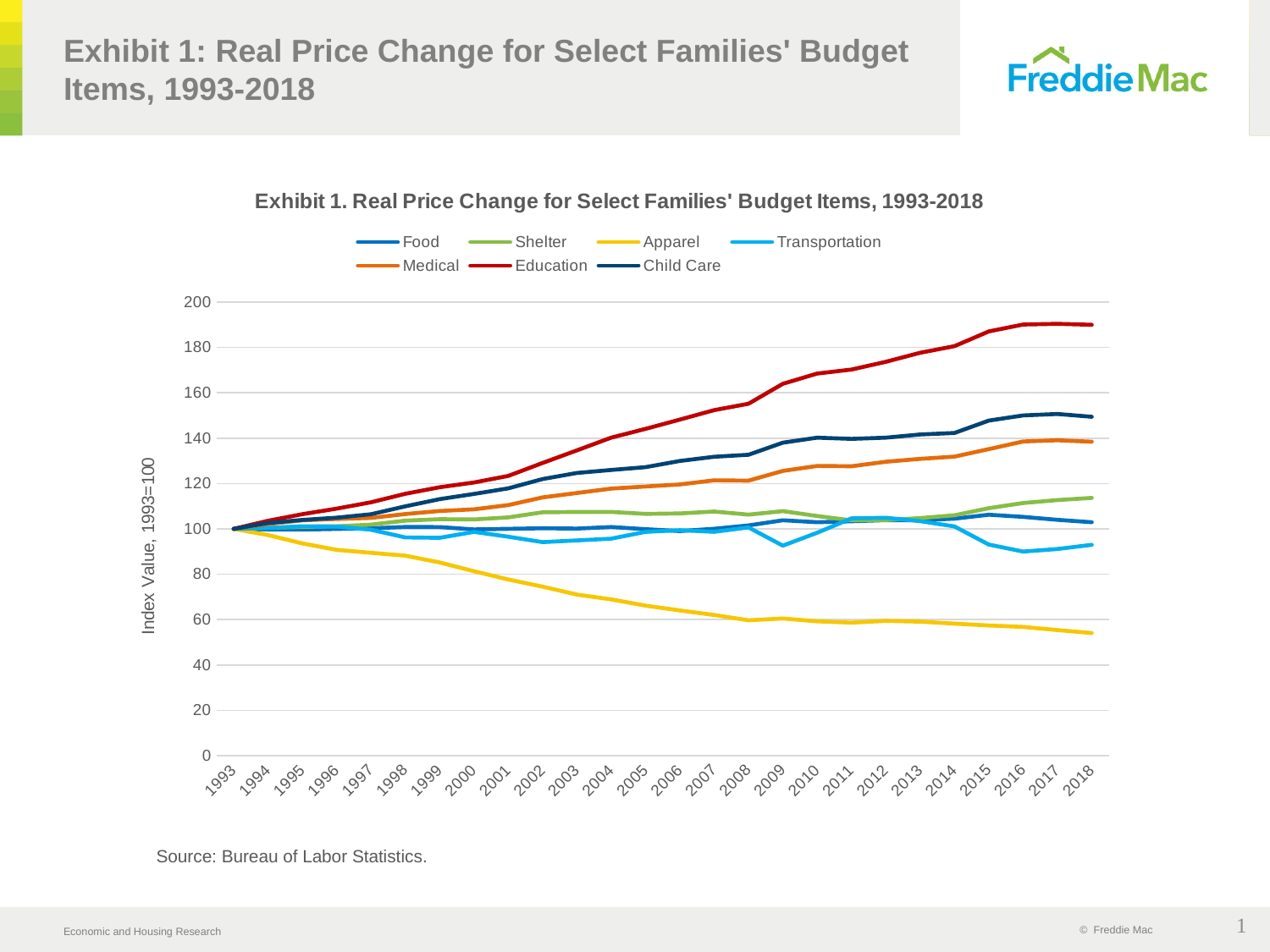
What is the label on the y axis? Index Value, 1993=100 Which series has the highest value in 2018? Education Which series has the lowest value in 2018? Apparel What is the index value for all series in 1993? 100 Is the value for Apparel in 2018 greater or less than 60? less How many years are plotted along the x axis? 26 Do the values for Education rise or fall from 1993 to 2018? Rise Do the values for Apparel rise or fall from 1993 to 2018? Fall What kind of chart is shown on the slide? Line chart Is the value for Education in 2018 greater or less than 180? greater How many series does the legend list? 7 Which is larger in 2018, Child Care or Medical? Child Care